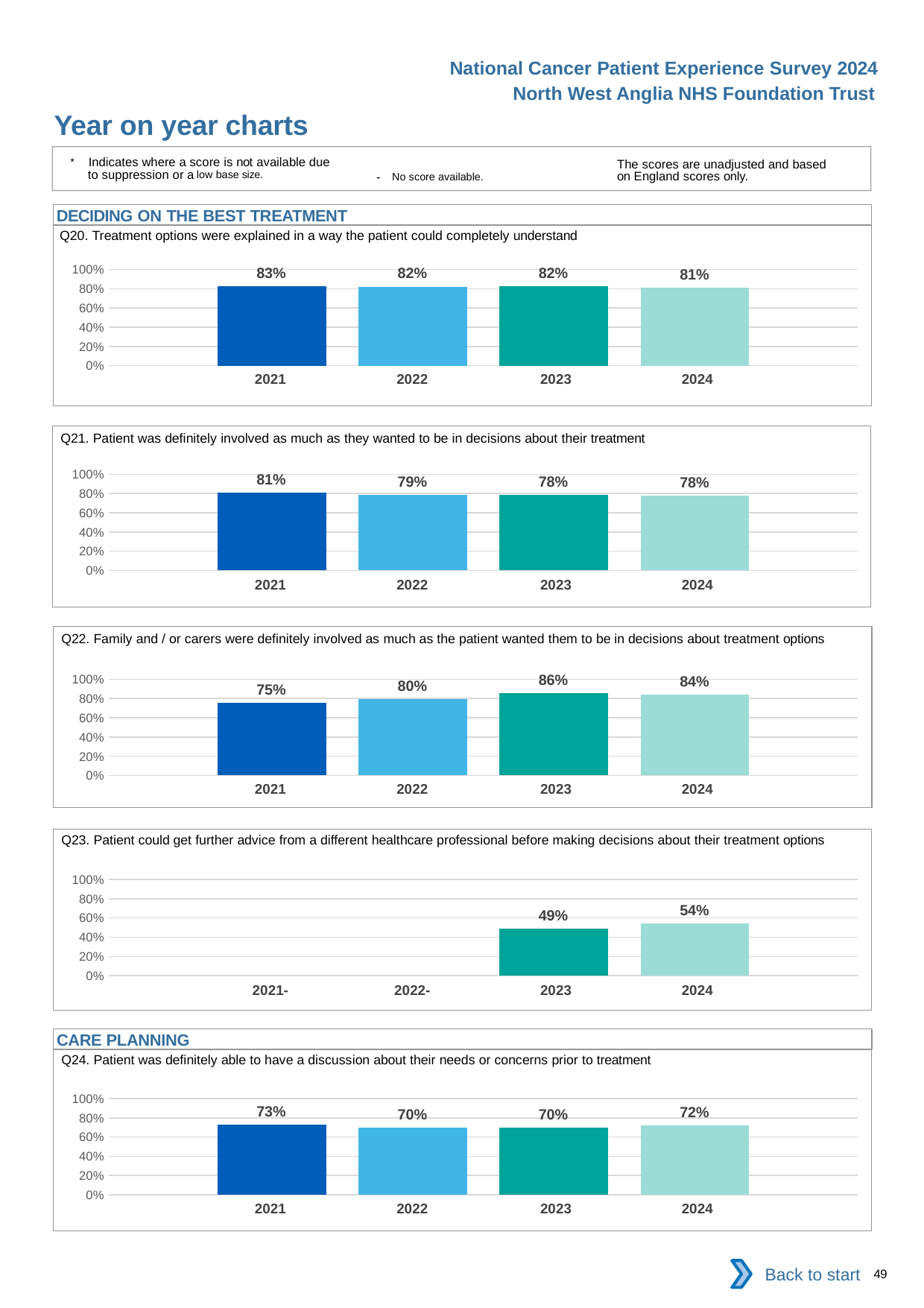
In the Q23 chart, what is the value for 2024? 54% In the Q21 chart, which year has the highest value? 2021 How many bars are plotted in the Q23 chart? 2 In the Q23 chart, which is larger, the value for 2023 or the value for 2024? 2024 In the Q22 chart, what is the difference between the 2023 and 2021 values? 11% What kind of chart is the Q20 chart? Bar chart In the Q24 chart, what is the value for 2022? 70% In the Q21 chart, do the values rise or fall from 2021 to 2024? Fall In the Q20 chart, what is the value for 2021? 83% In the Q23 chart, is the value for 2023 greater or less than 60%? less In the Q22 chart, which year has the lowest value? 2021 In the Q24 chart, what is the difference between the 2021 and 2022 values? 3%